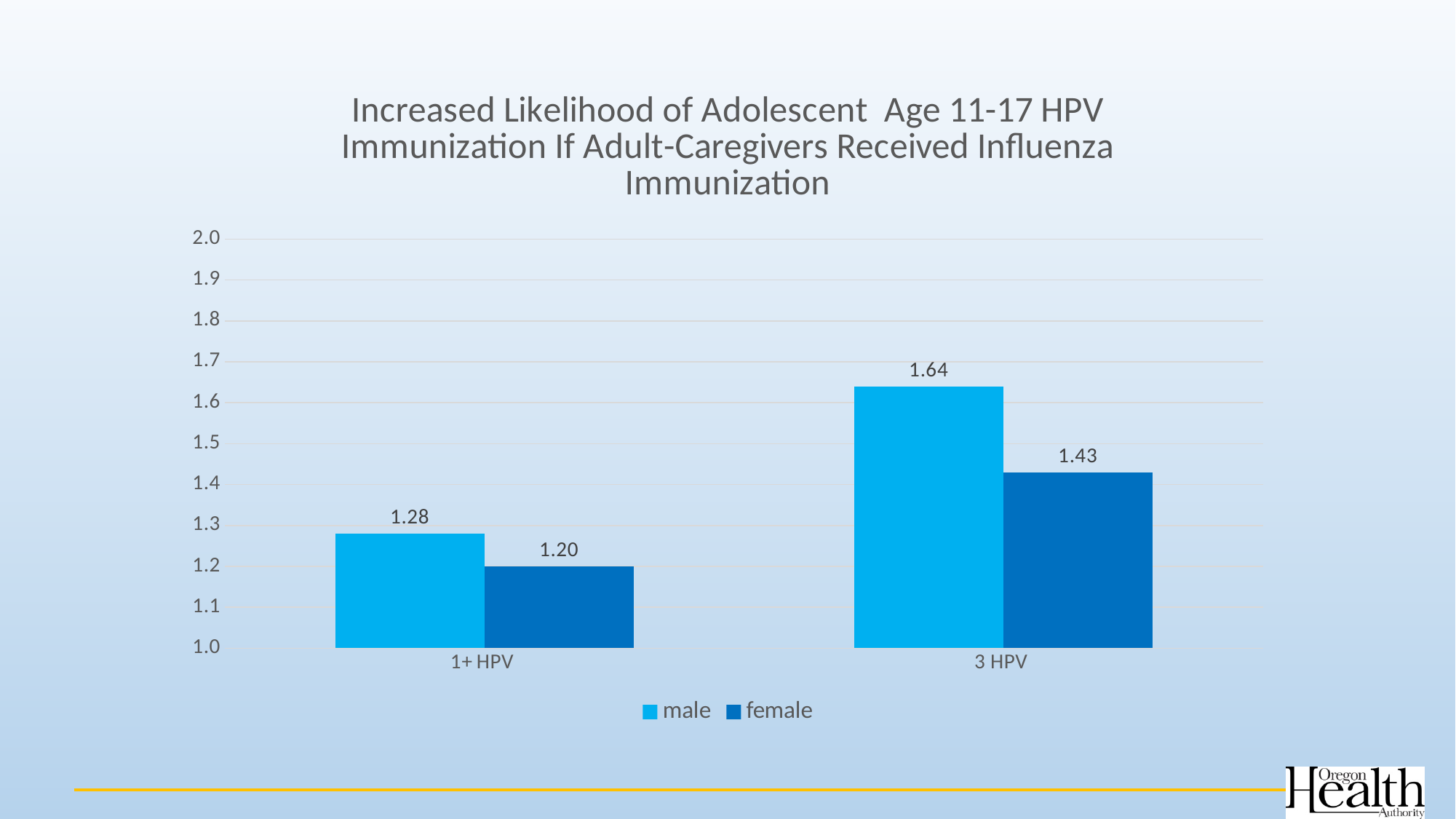
What is the value for female in the 3 HPV category? 1.43 How many series does the legend list? 2 Is the male value for 3 HPV greater or less than 1.5? greater What is the difference between the male values for 3 HPV and 1+ HPV? 0.36 What is the value for male in the 1+ HPV category? 1.28 Which category has the lowest value for the female series? 1+ HPV Which is larger, the male value for 1+ HPV or the female value for 3 HPV? female value for 3 HPV How many categories are shown on the x axis? 2 What is the value for female in the 1+ HPV category? 1.20 What is the difference between the male and female values in the 3 HPV category? 0.21 Which category has the highest value for the male series? 3 HPV What kind of chart is shown on the slide? bar chart